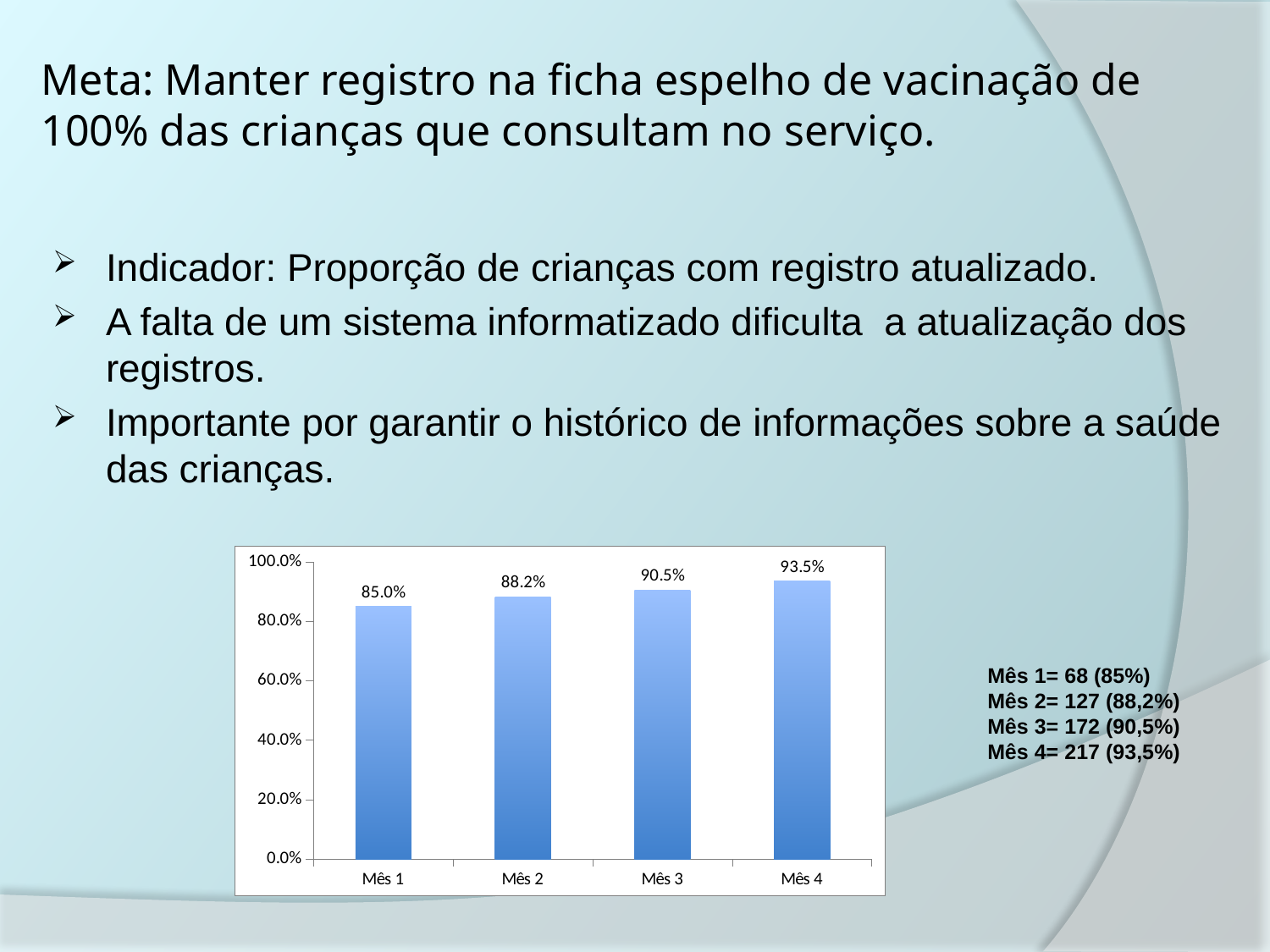
What is the difference between the values for Mês 4 and Mês 1? 8.5% Which month has the highest value? Mês 4 What is the value for Mês 1? 85.0% Do the values rise or fall from Mês 1 to Mês 4? rise What is the value for Mês 2? 88.2% What is the value for Mês 3? 90.5% How many months are shown on the x axis? 4 Which month has the lowest value? Mês 1 Is the value for Mês 1 greater or less than 80.0%? greater What kind of chart is shown on the slide? bar chart Which is larger, the value for Mês 2 or the value for Mês 3? Mês 3 What is the value for Mês 4? 93.5%